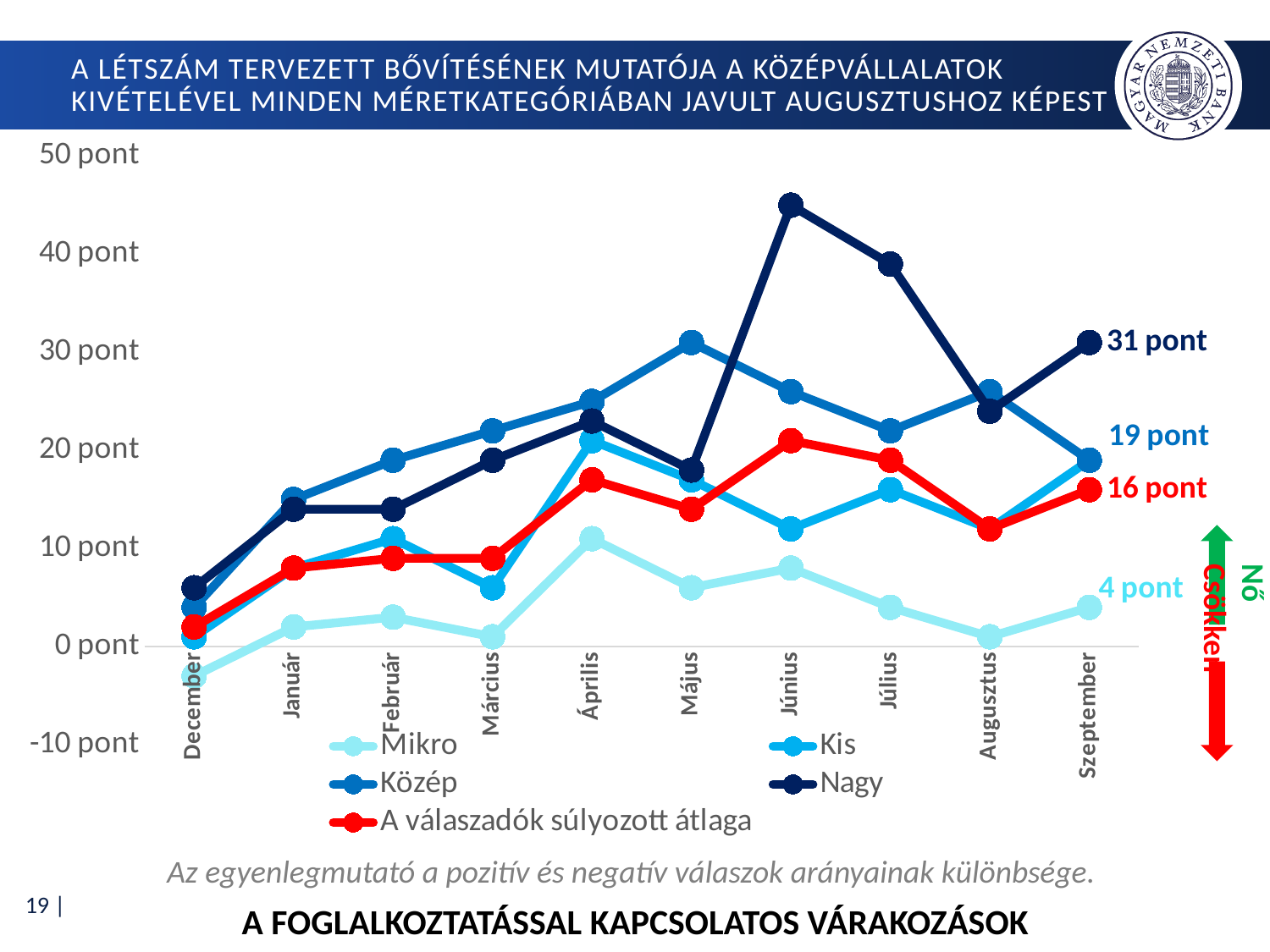
What value is labelled for 'A válaszadók súlyozott átlaga' in Szeptember? 16 pont What value is labelled for the Nagy series in Szeptember? 31 pont Which series has the highest value in Szeptember? Nagy What is the difference between the Nagy and Mikro values in Szeptember? 27 pont Which series has the lowest value in Szeptember? Mikro How many series does the legend list? 5 Is the value for Mikro in December greater or less than 0 pont? less How many months are shown along the x axis? 10 Does the Nagy series rise or fall from Június to Augusztus? fall What value is labelled for the Mikro series in Szeptember? 4 pont Is the value for Nagy in Június greater or less than 40 pont? greater What kind of chart is shown on the slide? line chart